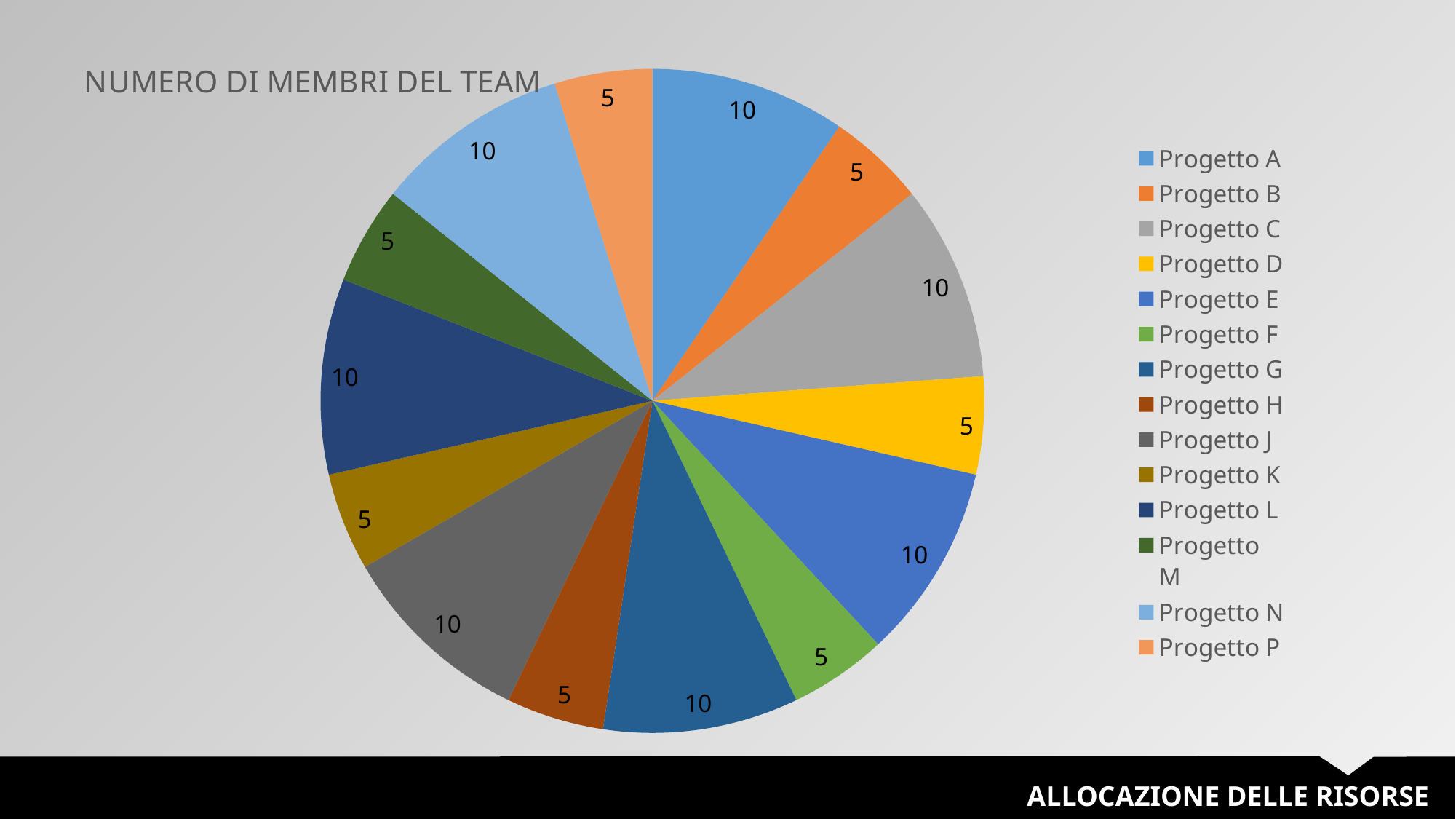
What is the value for Progetto A in the pie chart? 10 What is the value for Progetto B in the pie chart? 5 What is the value for Progetto D in the pie chart? 5 What is the value for Progetto K in the pie chart? 5 Which is larger, the value for Progetto C or the value for Progetto H? Progetto C What is the title of the pie chart? NUMERO DI MEMBRI DEL TEAM What is the value for Progetto N in the pie chart? 10 What is the difference between the value for Progetto E and the value for Progetto F? 5 What is the value for Progetto G in the pie chart? 10 What kind of chart is shown on the slide? pie chart How many categories does the pie chart have? 14 What colour is the slice for Progetto D in the pie chart? yellow